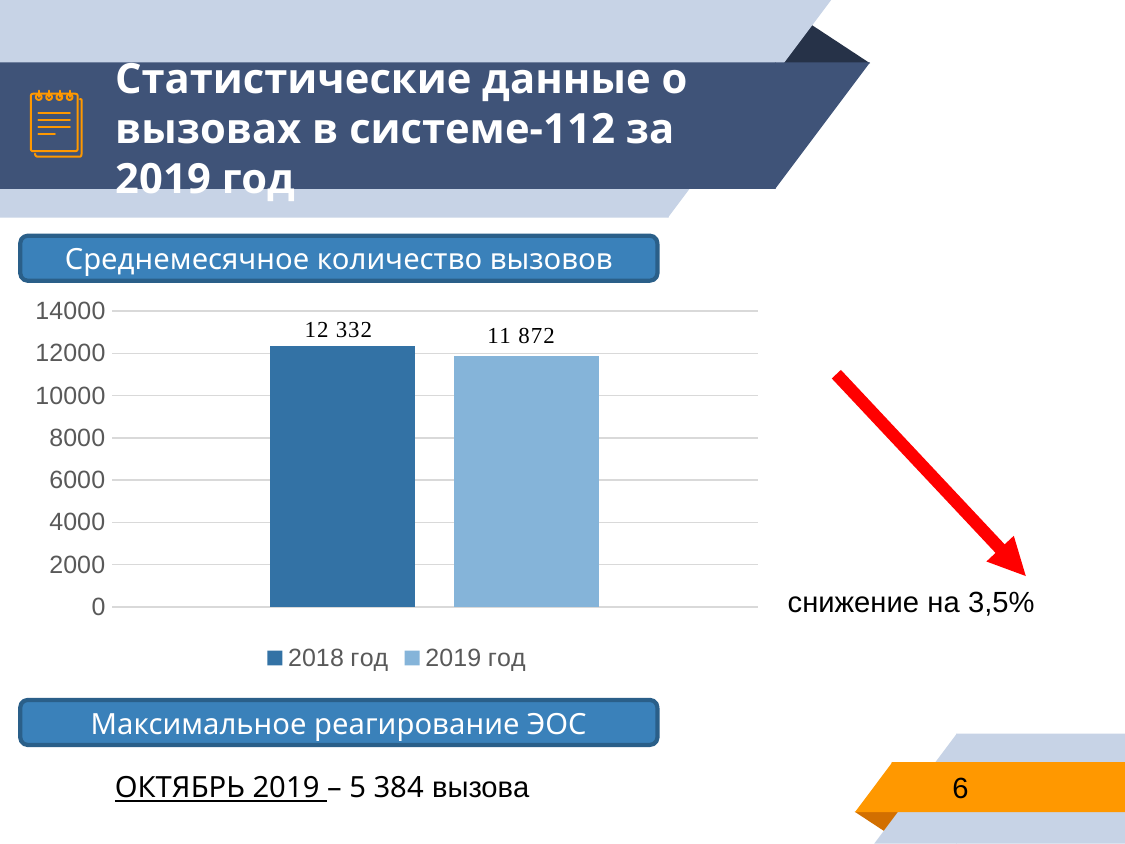
What is the title of the chart? Среднемесячное количество вызовов Is the value for 2018 год greater or less than 12000? greater Which year has the lower average monthly number of calls? 2019 год What is the average monthly number of calls for 2019 год? 11 872 Is the value for 2019 год greater or less than 12000? less What is the difference between the 2018 год and 2019 год values? 460 Do the values rise or fall from 2018 год to 2019 год? fall What kind of chart is shown on the slide? bar chart Which year has the higher average monthly number of calls? 2018 год What is the average monthly number of calls for 2018 год? 12 332 How many bars are plotted in the chart? 2 How many series does the legend list? 2